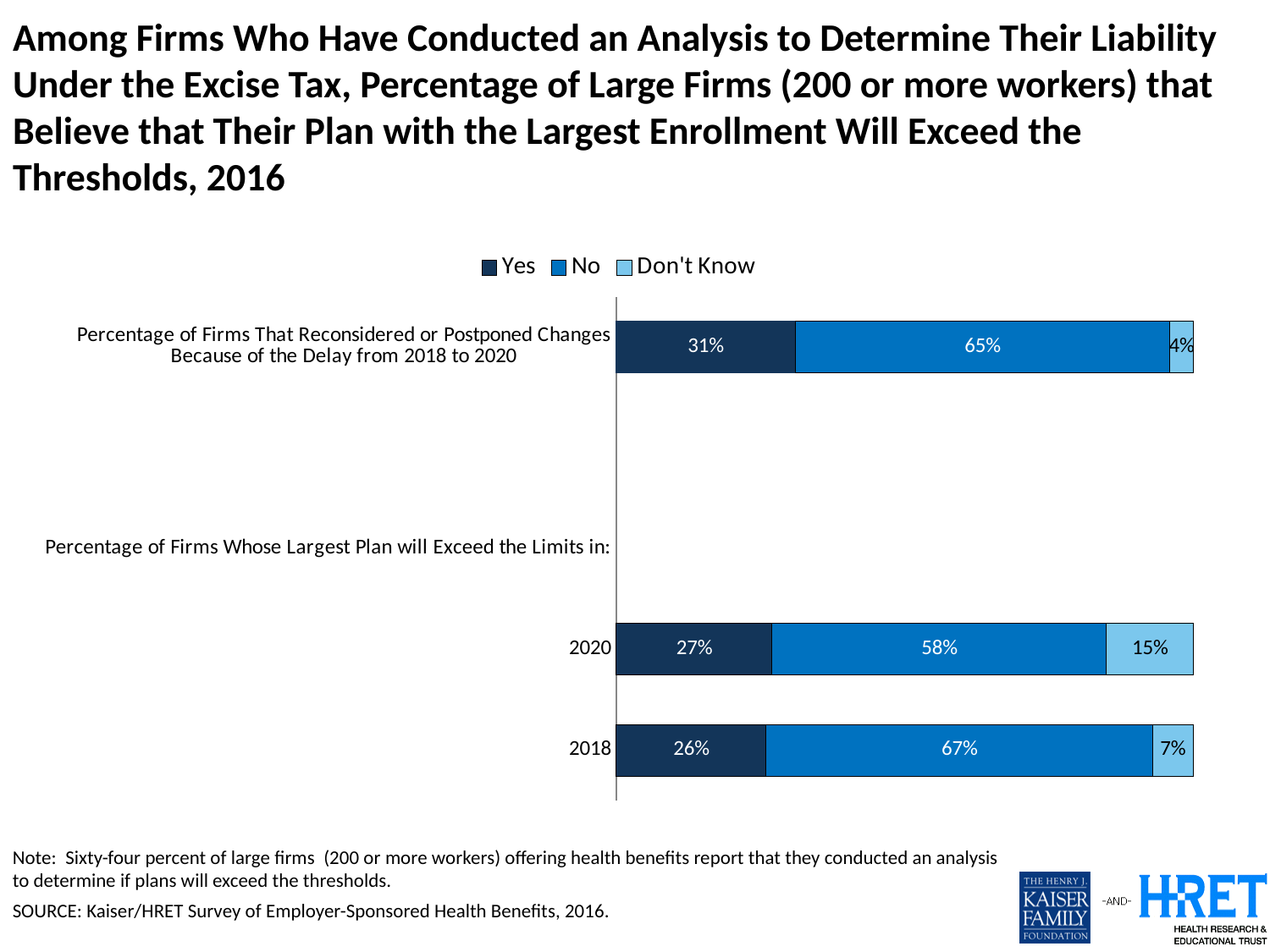
What is the "Don't Know" value for the bar on firms that reconsidered or postponed changes because of the delay from 2018 to 2020? 4% What are the three legend entries in the chart? Yes, No, Don't Know Which bar has the highest "Don't Know" value? 2020 What is the "Yes" value for firms that reconsidered or postponed changes because of the delay from 2018 to 2020? 31% Is the "Yes" value larger for 2018 or for 2020? 2020 What kind of chart is shown on the slide? Stacked bar chart How many bars are plotted in the chart? 3 Which bar has the lowest "No" value? 2020 What is the difference between the "No" values for 2018 and 2020? 9 percentage points What percentage of firms answered "No" for 2018 (largest plan will exceed the limits)? 67% What percentage of firms answered "Yes" for 2020 (largest plan will exceed the limits)? 27% How many series does the legend list? 3